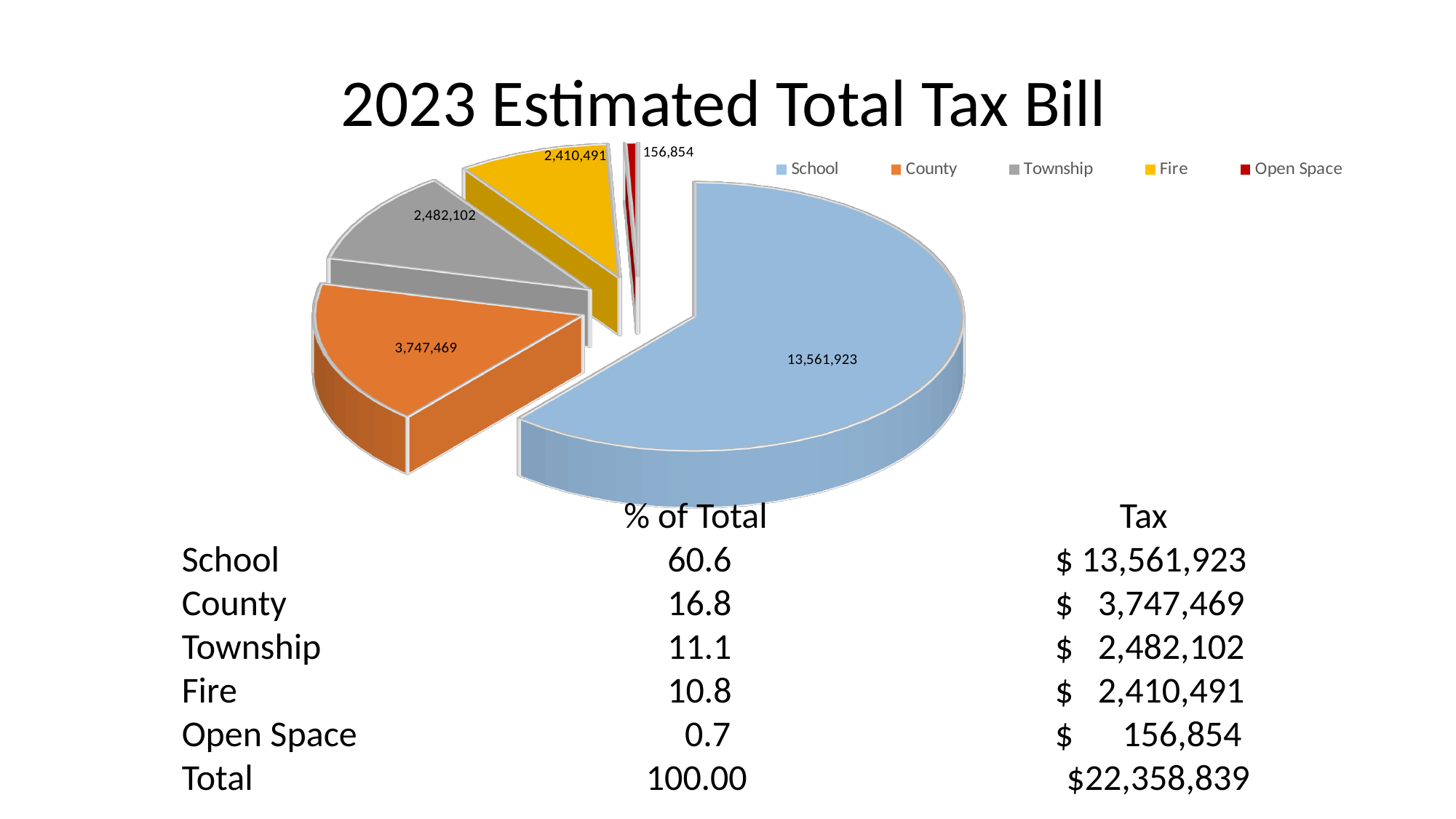
What is the value of the School slice in the pie chart? 13,561,923 Which category has the largest slice in the pie chart? School Which category has the smallest slice in the pie chart? Open Space Which is larger in the pie chart, the County slice or the Fire slice? County What is the value of the Fire slice in the pie chart? 2,410,491 How many entries does the legend list? 5 What is the difference between the County and Township values in the pie chart? 1,265,367 What is the value of the County slice in the pie chart? 3,747,469 How many slices does the pie chart have? 5 What is the value of the Open Space slice in the pie chart? 156,854 What colour is the School slice in the pie chart? light blue What type of chart is shown on the slide? pie chart